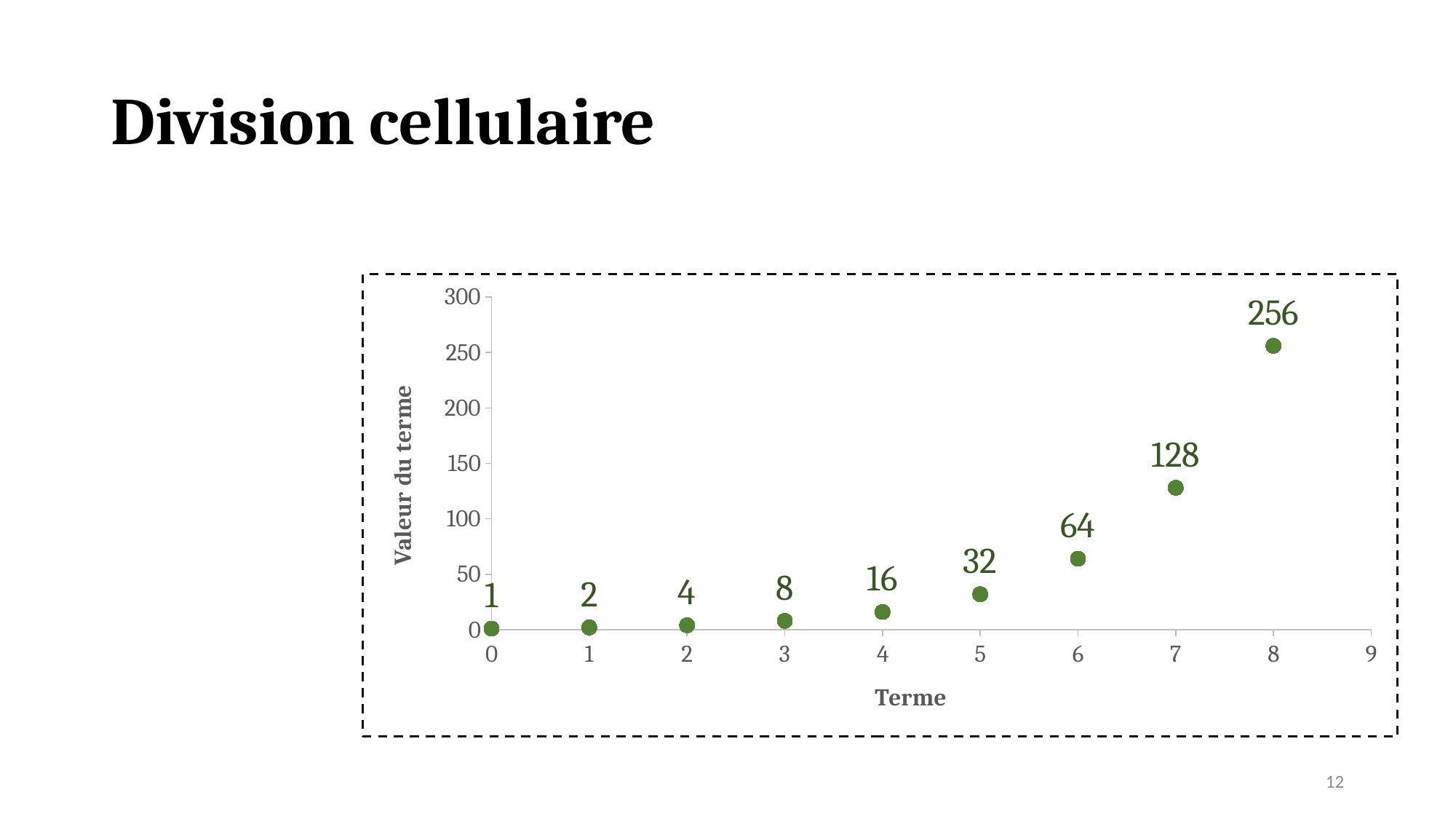
What is the difference between the values at Terme 6 and Terme 4? 48 At which Terme is the value of the term lowest? 0 What is the value of the term at Terme 5? 32 What kind of chart is shown on the slide? scatter chart Is the value at Terme 7 greater or less than 100? greater What is the difference between the values at Terme 8 and Terme 7? 128 Which is larger, the value at Terme 3 or the value at Terme 6? Terme 6 At which Terme is the value of the term highest? 8 Do the values rise or fall as Terme increases? rise What is the value of the term at Terme 0? 1 What is the value of the term at Terme 8? 256 How many data points are plotted on the chart? 9